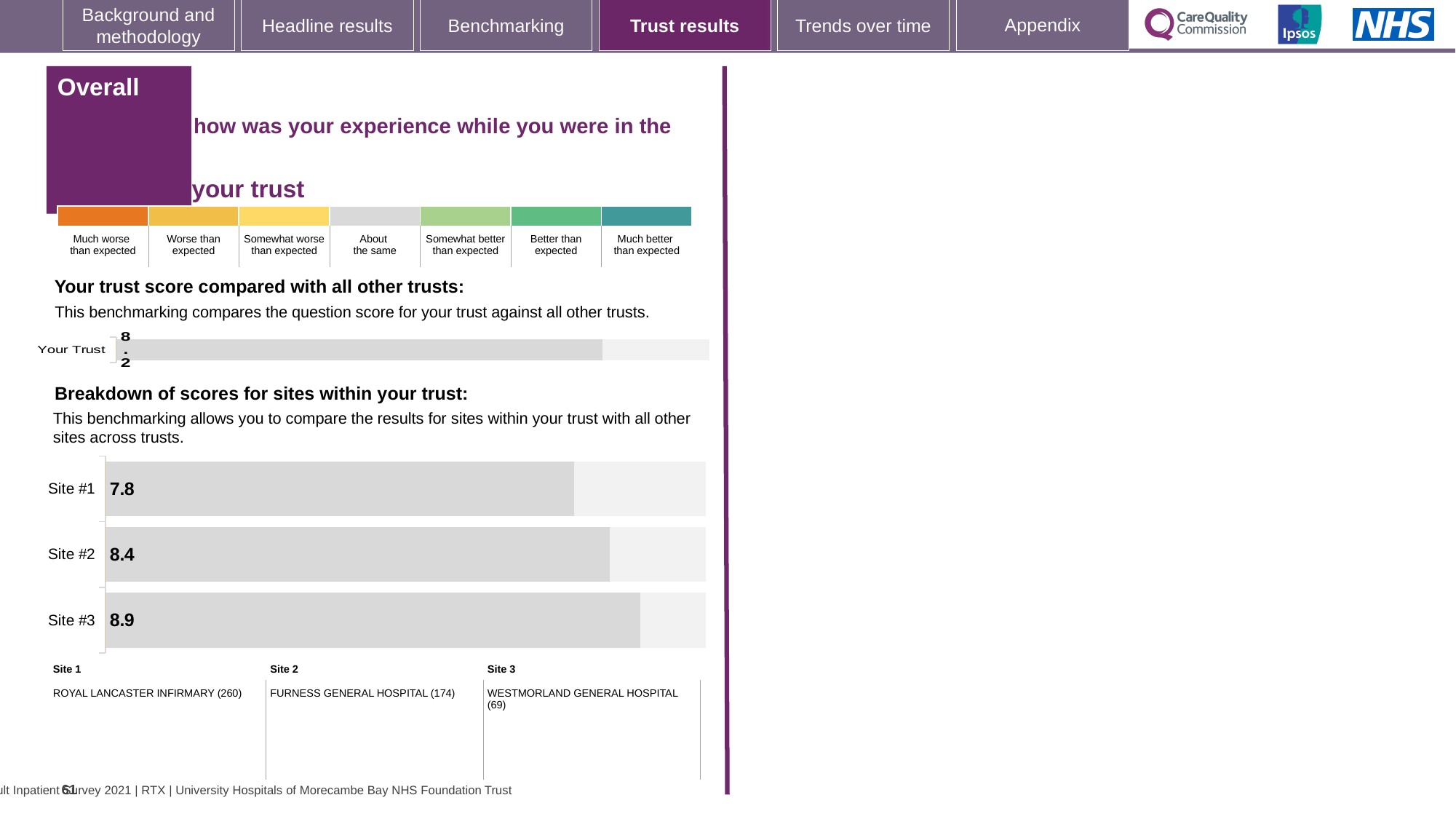
In the 'Breakdown of scores for sites within your trust' chart, which site has the highest score? Site #3 In the 'Your trust score compared with all other trusts' chart, what is the score shown for Your Trust? 8.2 In the 'Breakdown of scores for sites within your trust' chart, what is the difference between the scores of Site #3 and Site #1? 1.1 In the 'Breakdown of scores for sites within your trust' chart, which site has the lowest score? Site #1 In the 'Breakdown of scores for sites within your trust' chart, which has a higher score, Site #2 or Site #3? Site #3 In the 'Breakdown of scores for sites within your trust' chart, what is the score for Site #3? 8.9 In the 'Breakdown of scores for sites within your trust' chart, what is the score for Site #2? 8.4 How many sites are shown in the 'Breakdown of scores for sites within your trust' chart? 3 In the 'Breakdown of scores for sites within your trust' chart, what is the difference between the scores of Site #2 and Site #1? 0.6 What type of chart is used in the 'Breakdown of scores for sites within your trust' section? Bar chart In the 'Breakdown of scores for sites within your trust' chart, what is the score for Site #1? 7.8 In the 'Breakdown of scores for sites within your trust' chart, do the scores rise or fall from Site #1 to Site #3? Rise